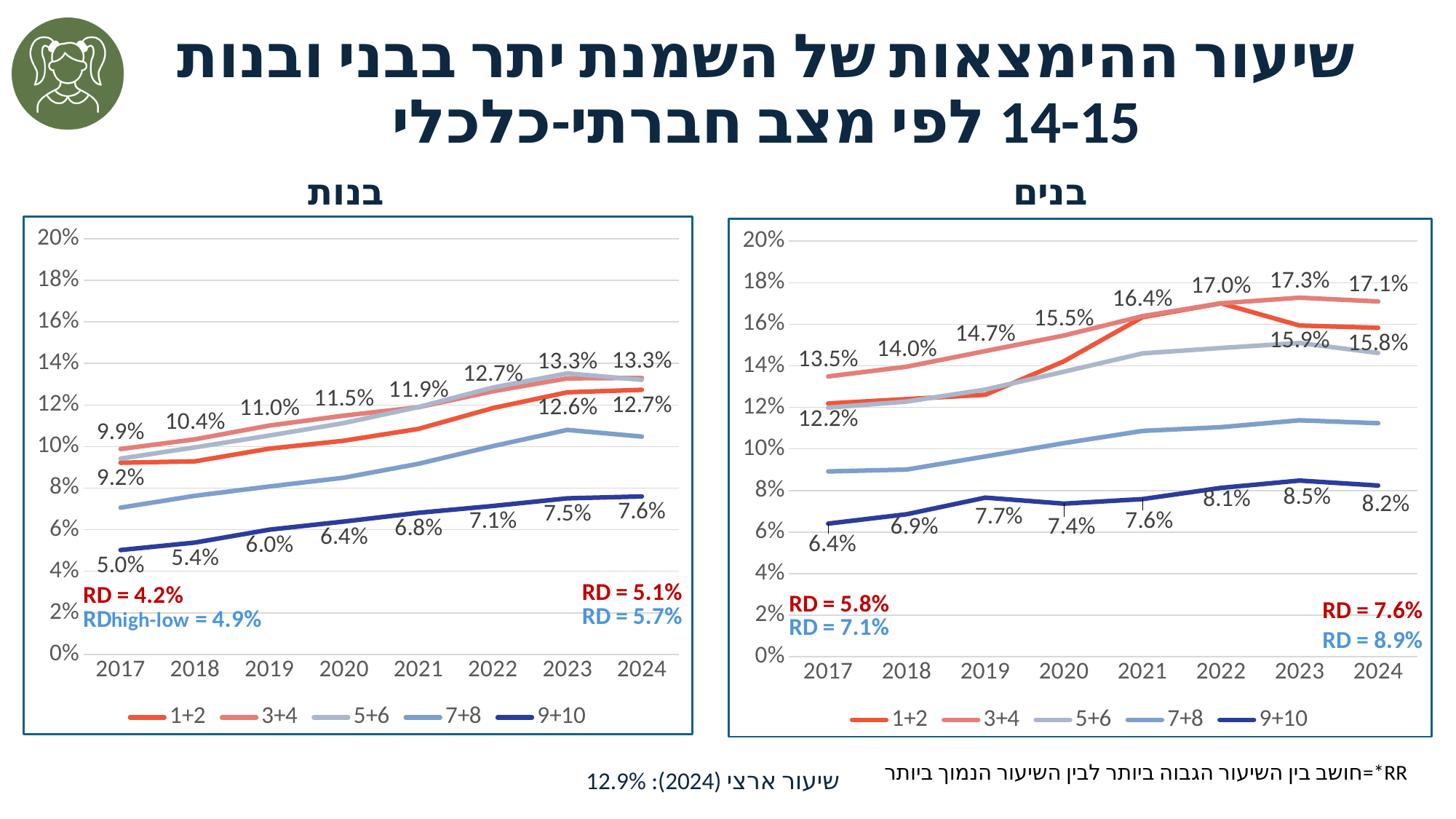
In the בנים chart, what is the difference between the 9+10 values in 2023 and 2017? 2.1% What type of charts are shown on the slide? Line charts In the בנים chart, what is the value for the 9+10 series in 2019? 7.7% In the בנות chart, what is the value for the 9+10 series in 2017? 5.0% In the בנים chart, is the value for the 7+8 series in 2024 greater or less than 10%? greater In the בנות chart, which series has the lowest values across all years? 9+10 In the בנות chart, what is the value for the 1+2 series in 2017? 9.2% In the בנים chart, what is the value for the 1+2 series in 2017? 12.2% How many years are shown on the x axis of the בנות chart? 8 In the בנות chart, does the 9+10 series rise or fall from 2017 to 2024? Rises In the בנות chart, what is the value for the 9+10 series in 2024? 7.6% How many series does the legend of the בנים chart list? 5